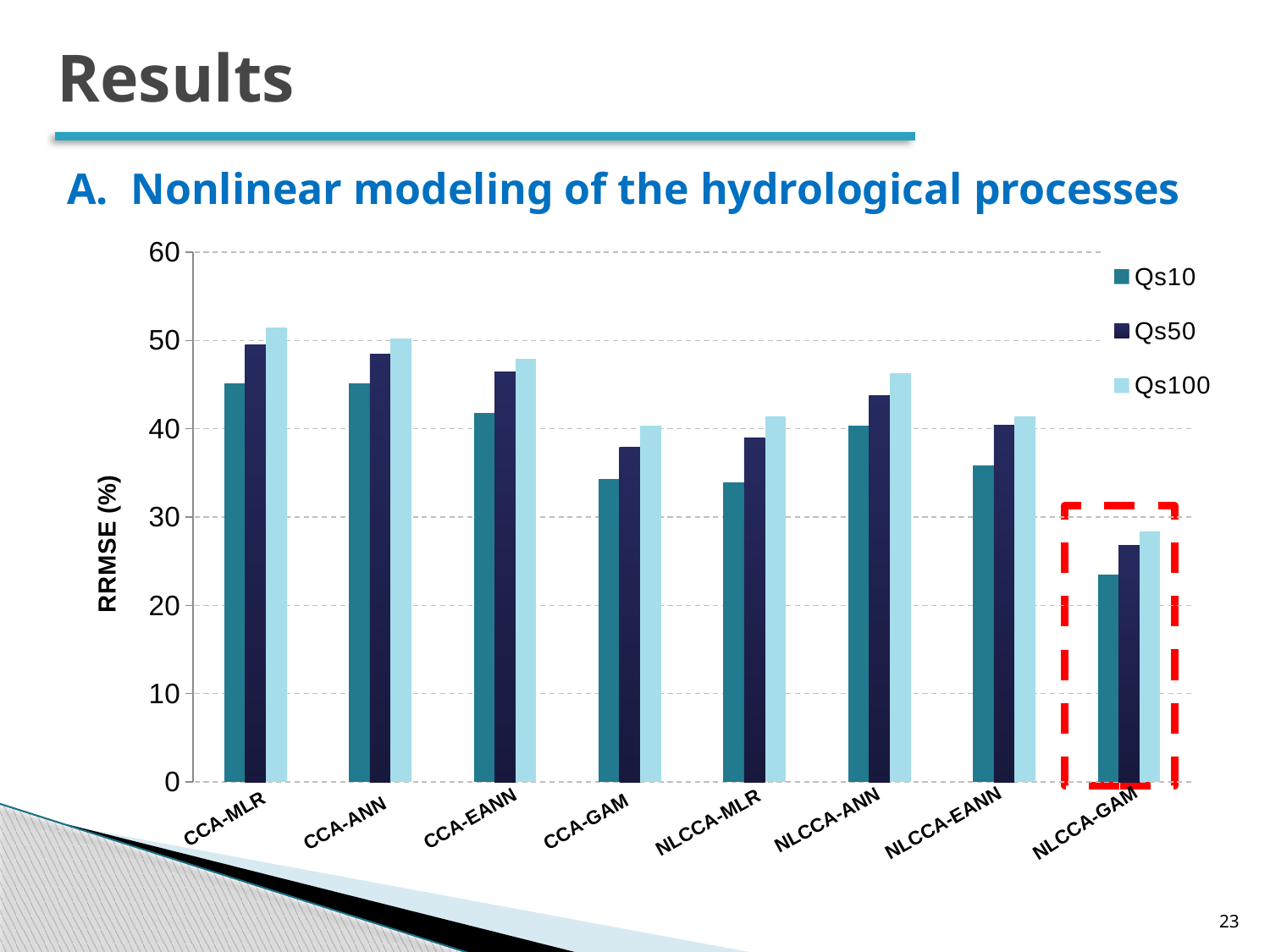
Is the Qs100 value for NLCCA-GAM greater or less than 30? less How many series does the legend list? 3 What kind of chart is shown on the slide? bar chart Is the Qs10 value for CCA-GAM greater or less than 40? less Within each category, does the RRMSE rise or fall going from Qs10 to Qs100? rise Is the Qs100 value for CCA-MLR greater or less than 50? greater Which category has the lowest Qs10 RRMSE value? NLCCA-GAM Which category has the highest Qs100 RRMSE value? CCA-MLR Which is larger, the Qs50 value for NLCCA-ANN or the Qs50 value for CCA-GAM? NLCCA-ANN What is the label of the y axis? RRMSE (%) How many model categories are shown on the x axis? 8